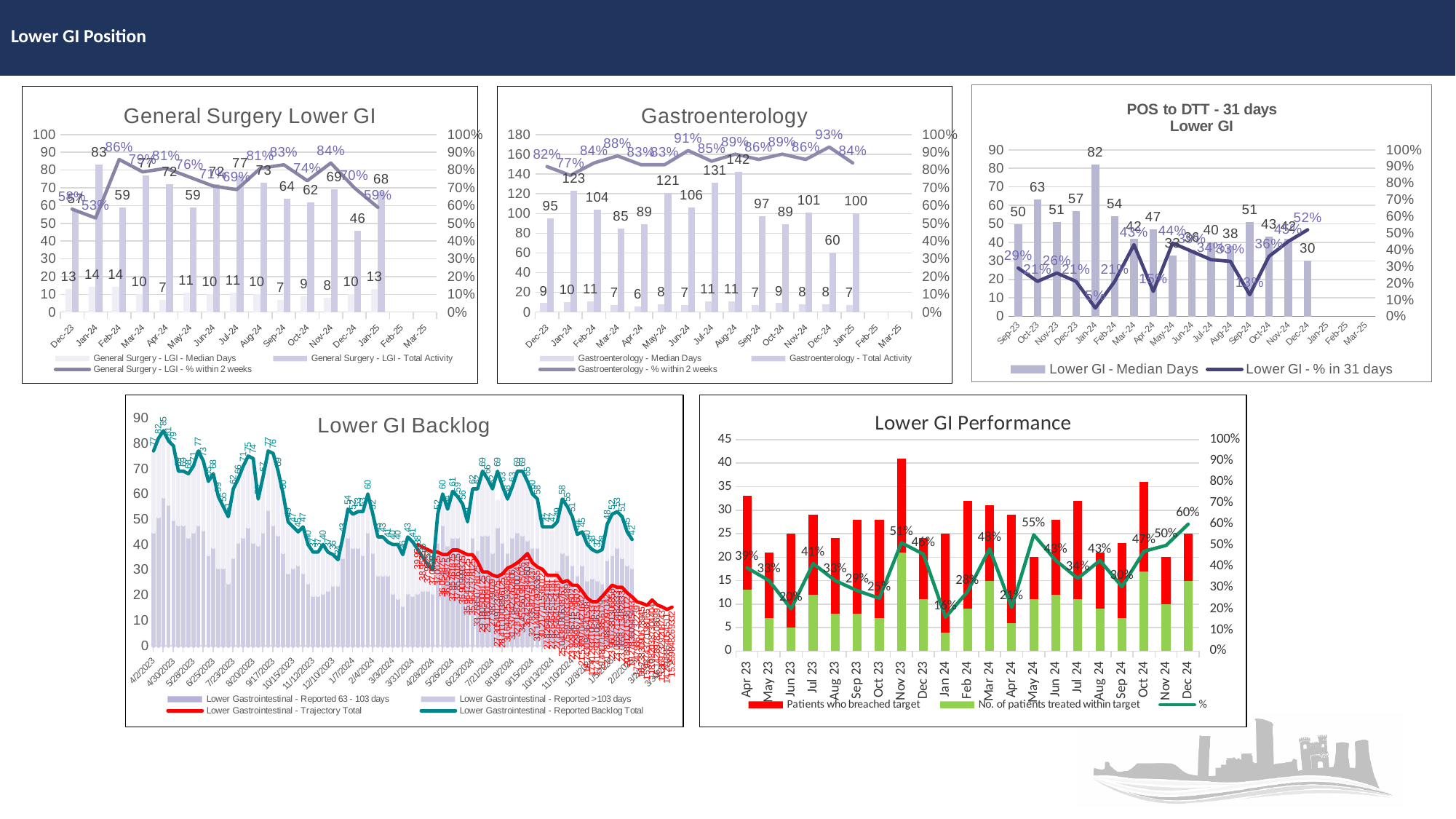
In the General Surgery Lower GI chart, what is the Total Activity value for Jan-24? 83 In the General Surgery Lower GI chart, which month has the lowest Total Activity? Dec-24 How many series does the legend of the Lower GI Performance chart list? 3 In the POS to DTT - 31 days Lower GI chart, which month has the lowest % in 31 days? Jan-24 In the Gastroenterology chart, what is the Total Activity value for Aug-24? 142 In the General Surgery Lower GI chart, what is the % within 2 weeks for Feb-24? 86% In the Lower GI Performance chart, which is larger, the % for Nov 23 or the % for Jan 24? Nov 23 In the Lower GI Performance chart, what is the % value for Dec 24? 60% In the Gastroenterology chart, which month has the highest % within 2 weeks? Dec-24 In the POS to DTT - 31 days Lower GI chart, what is the % in 31 days for Dec-24? 52% In the POS to DTT - 31 days Lower GI chart, what is the Median Days value for Jan-24? 82 In the Gastroenterology chart, what is the difference in Total Activity between Aug-24 and Dec-24? 82